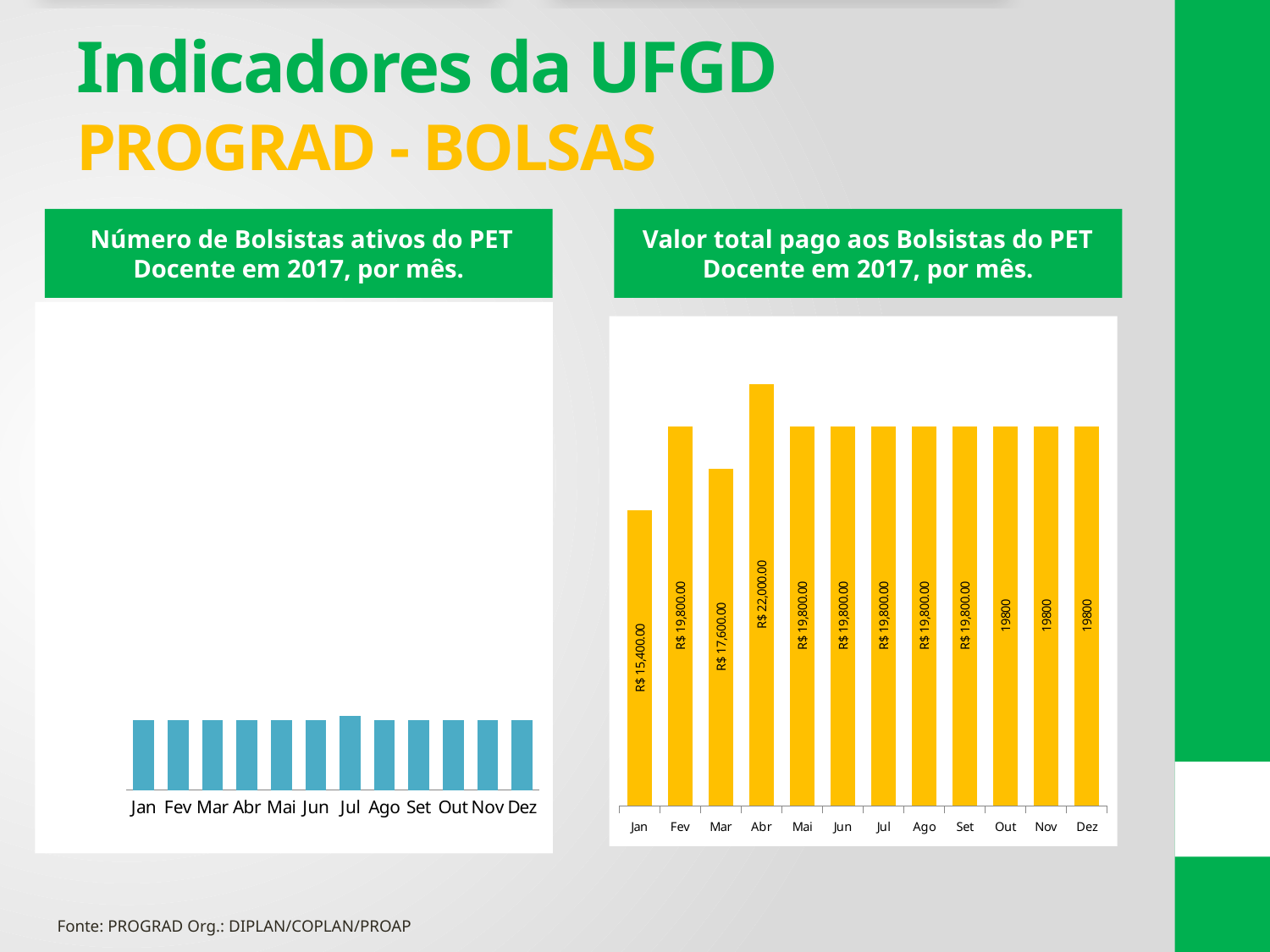
On the right chart (Valor total pago aos Bolsistas do PET Docente em 2017, por mês), what is the value for Jan? R$ 15,400.00 On the right chart (Valor total pago aos Bolsistas do PET Docente em 2017, por mês), how many months are plotted? 12 On the right chart (Valor total pago aos Bolsistas do PET Docente em 2017, por mês), which month has the highest value? Abr On the right chart (Valor total pago aos Bolsistas do PET Docente em 2017, por mês), what is the difference between the values for Abr and Jan? R$ 6,600.00 On the right chart (Valor total pago aos Bolsistas do PET Docente em 2017, por mês), what is the value labelled for Nov? 19800 On the left chart (Número de Bolsistas ativos do PET Docente em 2017, por mês), which month has the highest bar? Jul On the right chart (Valor total pago aos Bolsistas do PET Docente em 2017, por mês), what is the value for Mar? R$ 17,600.00 On the right chart (Valor total pago aos Bolsistas do PET Docente em 2017, por mês), which month has the lowest value? Jan What kind of chart is the left chart (Número de Bolsistas ativos do PET Docente em 2017, por mês)? Bar chart On the left chart (Número de Bolsistas ativos do PET Docente em 2017, por mês), how many months are shown on the x axis? 12 On the right chart (Valor total pago aos Bolsistas do PET Docente em 2017, por mês), which is larger, the value for Mar or the value for Fev? Fev On the right chart (Valor total pago aos Bolsistas do PET Docente em 2017, por mês), what is the value for Abr? R$ 22,000.00